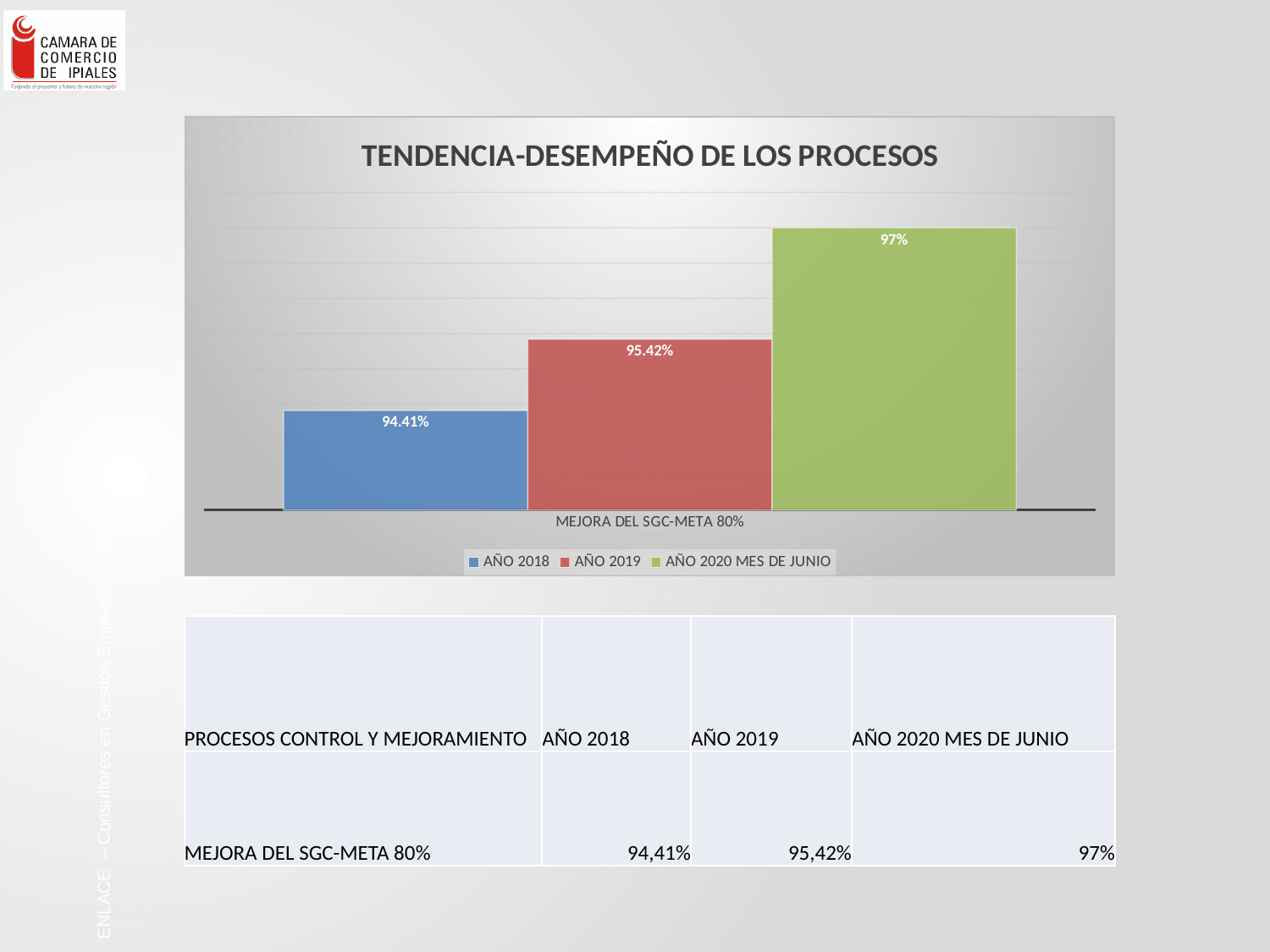
Which series has the lowest value in the chart? AÑO 2018 Which series has the highest value in the chart? AÑO 2020 MES DE JUNIO Do the values rise or fall from AÑO 2018 to AÑO 2020 MES DE JUNIO? Rise Which is larger, the value for AÑO 2018 or the value for AÑO 2020 MES DE JUNIO? AÑO 2020 MES DE JUNIO What is the value for AÑO 2020 MES DE JUNIO in the chart? 97% What is the value for AÑO 2018 in the chart? 94.41% How many series does the legend list? 3 What is the value for AÑO 2019 in the chart? 95.42% What is the difference between the AÑO 2020 MES DE JUNIO and AÑO 2019 values? 1.58% What is the difference between the AÑO 2019 and AÑO 2018 values? 1.01% What kind of chart is shown on the slide? Bar chart What is the title of the chart? TENDENCIA-DESEMPEÑO DE LOS PROCESOS